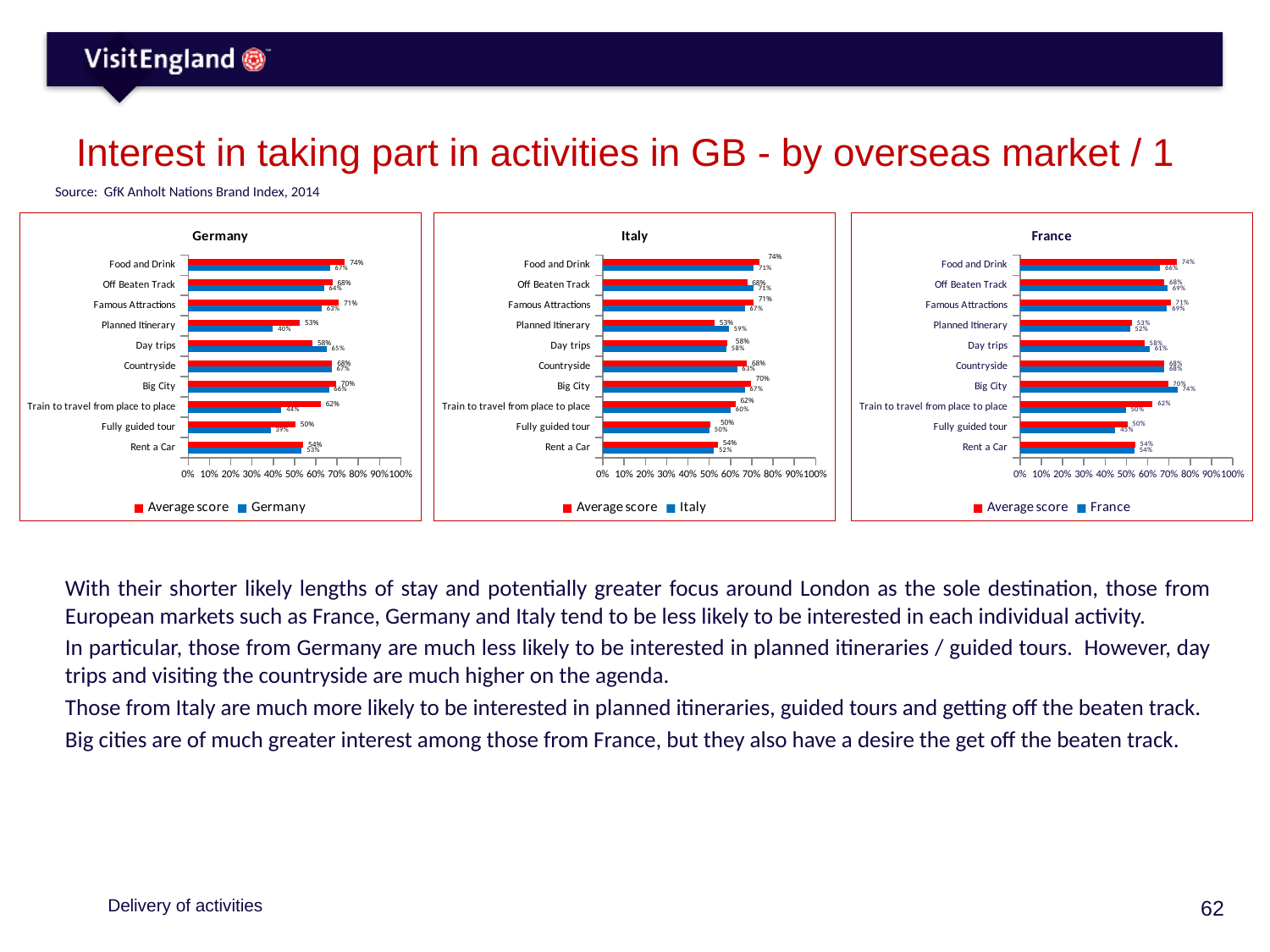
In the Germany chart, which activity has the lowest Germany value? Fully guided tour In the France chart, which is larger for Train to travel from place to place: the Average score or the France value? Average score What type of chart is used for the Germany chart? Bar chart In the Germany chart, what is the Germany value for Fully guided tour? 39% In the Germany chart, what is the difference between the Average score and the Germany value for Train to travel from place to place? 18% In the Germany chart, what is the Germany value for Planned Itinerary? 40% How many activity categories are shown in the France chart? 10 In the Germany chart, what is the Average score for Food and Drink? 74% In the Italy chart, which activity has the highest Average score? Food and Drink How many series does the legend of the Italy chart list? 2 In the Italy chart, what is the Italy value for Planned Itinerary? 59% In the France chart, what is the France value for Big City? 74%